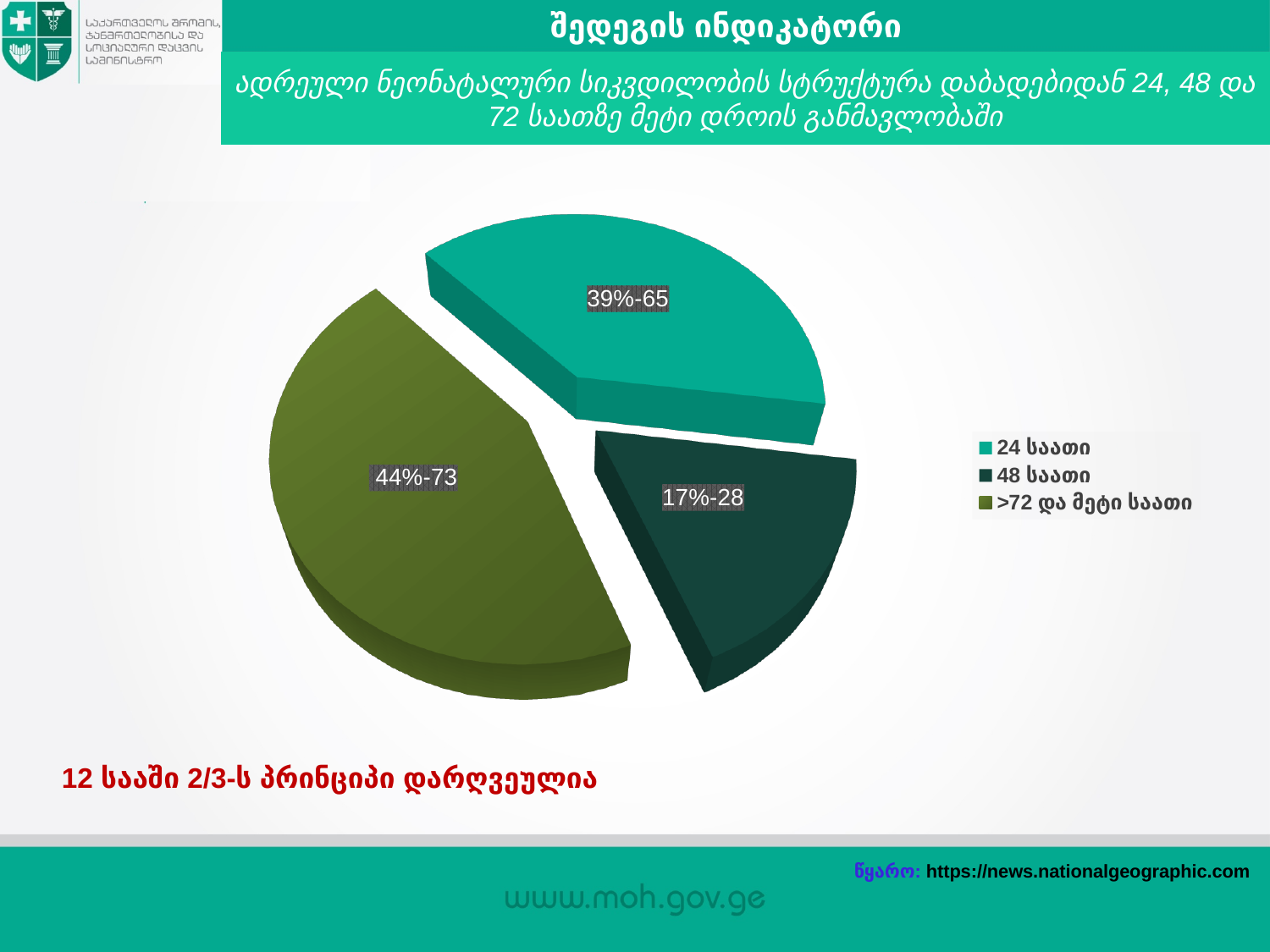
What kind of chart is shown on the slide? pie chart Which category has the largest share of the pie? >72 და მეტი საათი Which category has the smallest share of the pie? 48 საათი Which is larger, the share for "24 საათი" or the share for "48 საათი"? 24 საათი How many entries does the legend of the pie chart list? 3 How many slices does the pie chart have? 3 What is the data label shown on the slice for "24 საათი"? 39%-65 What is the difference in percentage points between the ">72 და მეტი საათი" slice and the "24 საათი" slice? 5 What is the data label shown on the slice for "48 საათი"? 17%-28 What is the data label shown on the slice for ">72 და მეტი საათი"? 44%-73 What percentage share of the pie does the "48 საათი" slice have? 17% What colour is the slice for "24 საათი" in the pie chart? teal